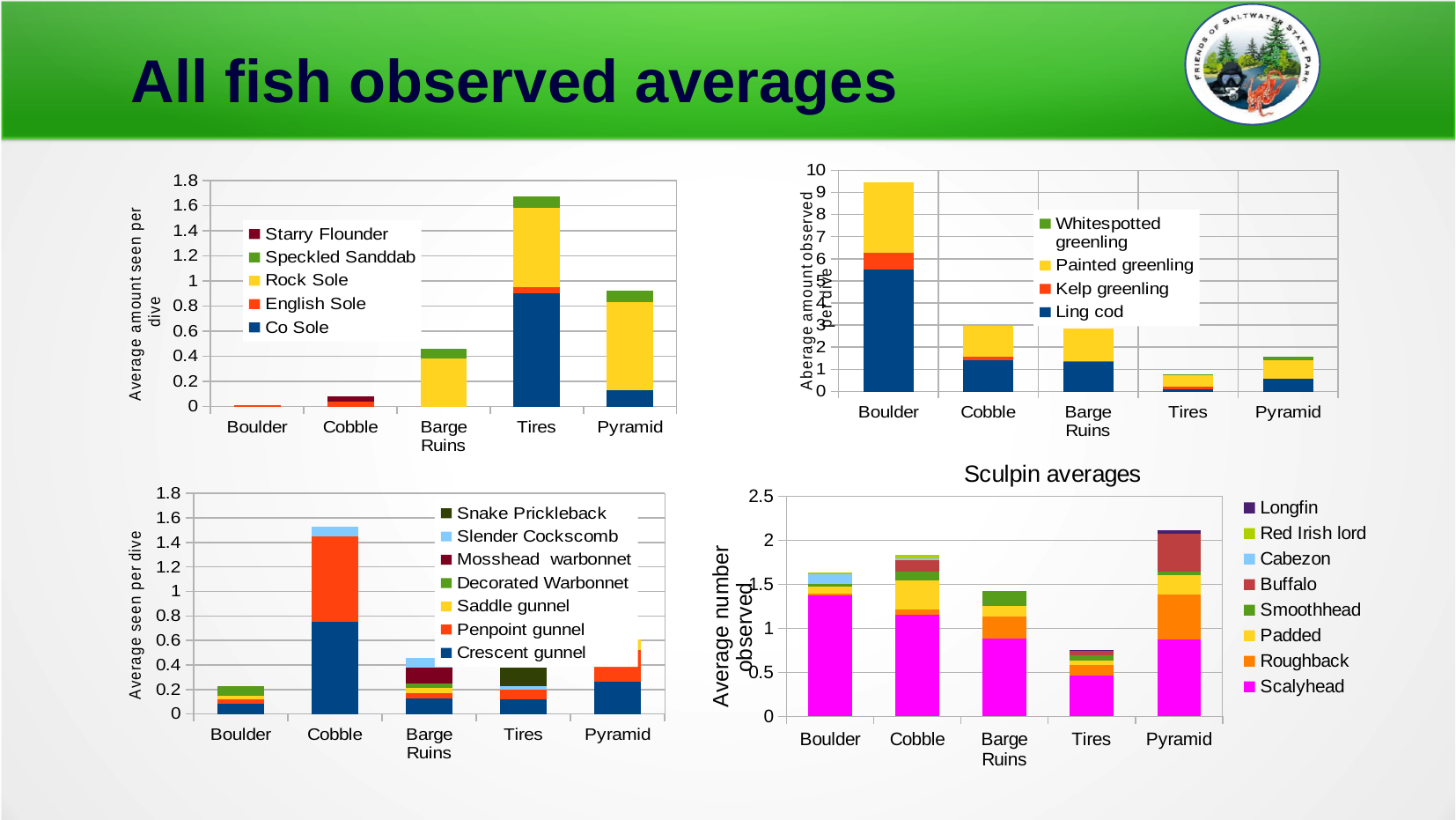
How many series does the legend of the 'Sculpin averages' chart list? 8 In the top-right chart (Ling cod and greenlings), is the total for Boulder greater or less than 8? greater In the 'Sculpin averages' chart, which site has the shortest stacked bar? Tires How many series does the legend of the top-right chart (Ling cod and greenlings) list? 4 In the top-left chart (Co Sole, English Sole, Rock Sole, etc.), which site has the tallest stacked bar? Tires How many sites are shown on the x axis of the top-left chart (Co Sole, English Sole, Rock Sole, etc.)? 5 What kind of chart is the 'Sculpin averages' chart? bar chart In the top-right chart (Ling cod and greenlings), which site has the tallest stacked bar? Boulder In the 'Sculpin averages' chart, is the total for Tires greater or less than 1? less In the bottom-left chart (gunnels and pricklebacks), which site has the tallest stacked bar? Cobble In the bottom-left chart (gunnels and pricklebacks), is the total for Cobble greater or less than 1? greater